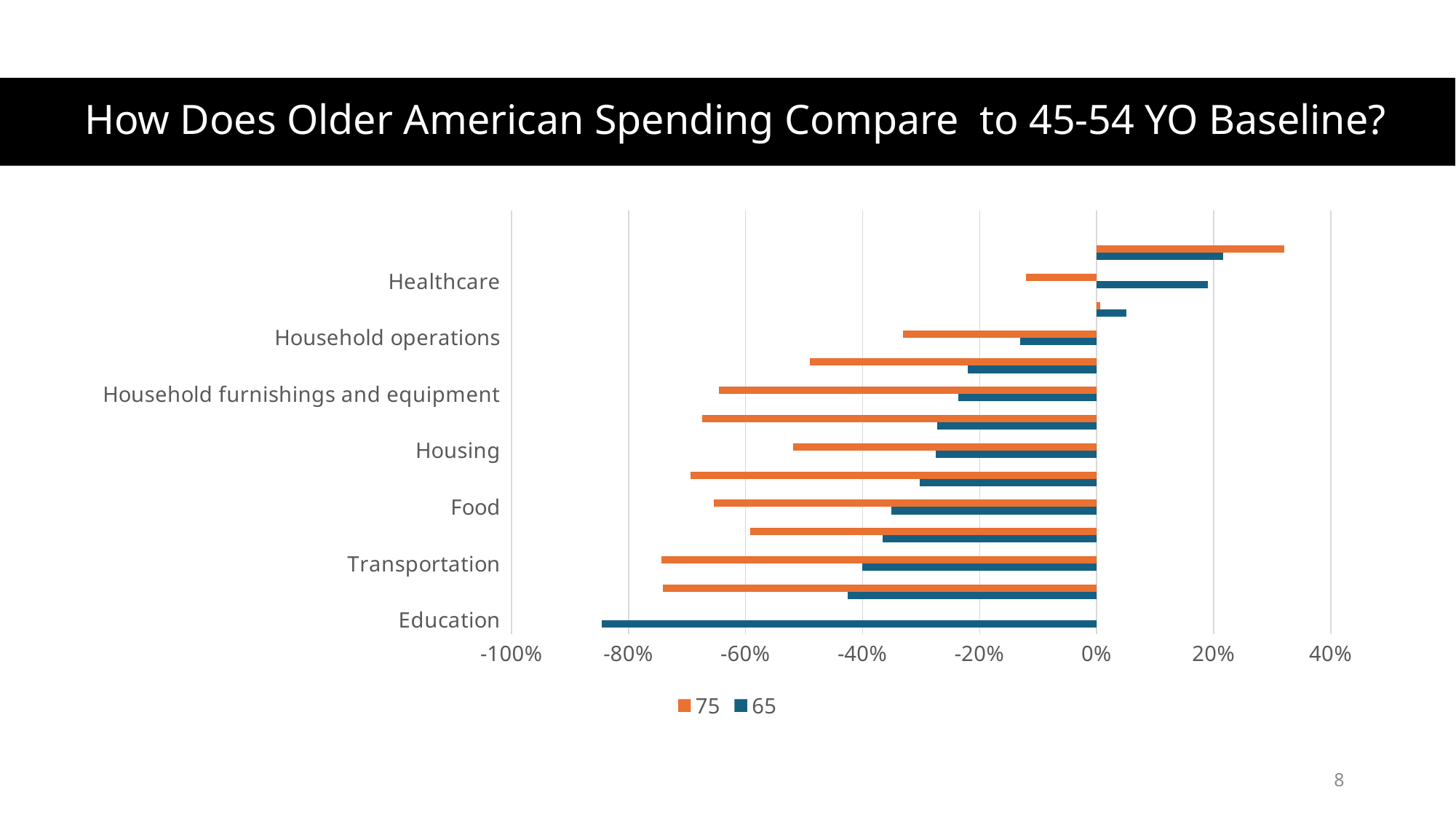
Is the value for Education in the 65 series greater or less than -80%? less Which colour represents the 75 series? Orange What are the two series named in the legend? 75 and 65 Is the value for Food in the 65 series greater or less than -20%? less For Healthcare, which series has the larger value, 75 or 65? 65 Is the value for Healthcare in the 65 series greater or less than 0%? greater What kind of chart is shown on the slide? Bar chart Which labelled category has the lowest value in the 65 series? Education How many series does the legend list? 2